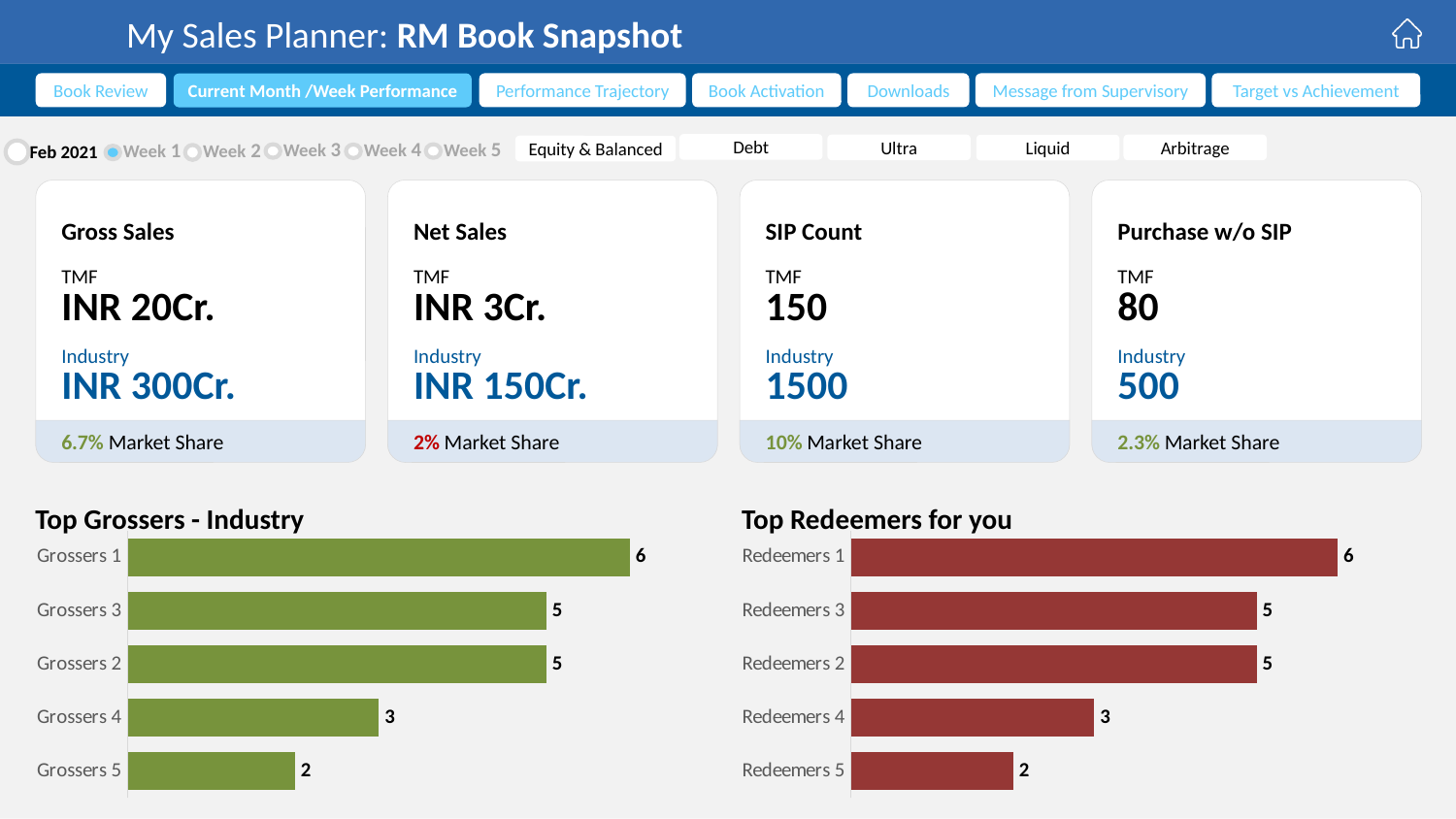
In the 'Top Redeemers for you' chart, what is the value for Redeemers 5? 2 In the 'Top Redeemers for you' chart, what is the difference between Redeemers 2 and Redeemers 4? 2 In the 'Top Redeemers for you' chart, what is the value for Redeemers 3? 5 In the 'Top Grossers - Industry' chart, what is the value for Grossers 1? 6 In the 'Top Redeemers for you' chart, which is larger: Redeemers 1 or Redeemers 4? Redeemers 1 How many categories are shown in the 'Top Grossers - Industry' chart? 5 What colour are the bars in the 'Top Grossers - Industry' chart? Green In the 'Top Grossers - Industry' chart, what is the difference between Grossers 1 and Grossers 5? 4 In the 'Top Grossers - Industry' chart, which category has the lowest value? Grossers 5 What kind of chart is 'Top Redeemers for you'? Bar chart In the 'Top Grossers - Industry' chart, what is the value for Grossers 4? 3 In the 'Top Grossers - Industry' chart, which category has the highest value? Grossers 1